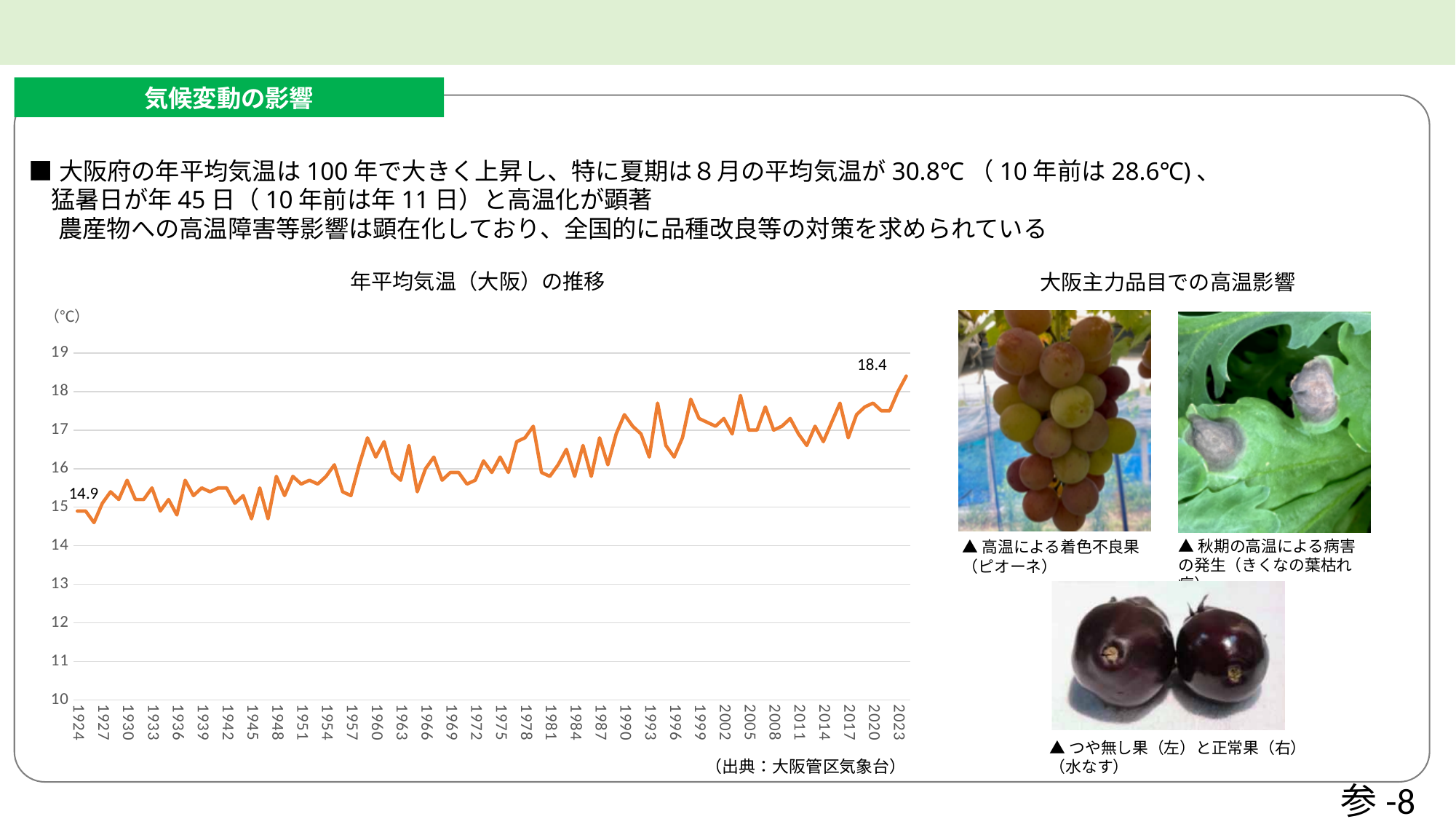
Is the value for 1945 in the chart 年平均気温（大阪）の推移 greater or less than 15? less What is the value labelled at the start of the line (1924) in the chart 年平均気温（大阪）の推移? 14.9 By how much does the labelled 2023 value exceed the labelled 1924 value in the chart 年平均気温（大阪）の推移? 3.5 What unit is shown on the vertical axis of the chart 年平均気温（大阪）の推移? ℃ What source is cited below the chart 年平均気温（大阪）の推移? 大阪管区気象台 Is the value for 1990 in the chart 年平均気温（大阪）の推移 greater or less than 17? greater Do the values in the chart 年平均気温（大阪）の推移 generally rise or fall from 1924 to 2023? rise What is the value labelled at the end of the line (2023) in the chart 年平均気温（大阪）の推移? 18.4 What kind of chart is 年平均気温（大阪）の推移? line chart Which of the two labelled values in the chart 年平均気温（大阪）の推移 is larger, 1924 or 2023? 2023